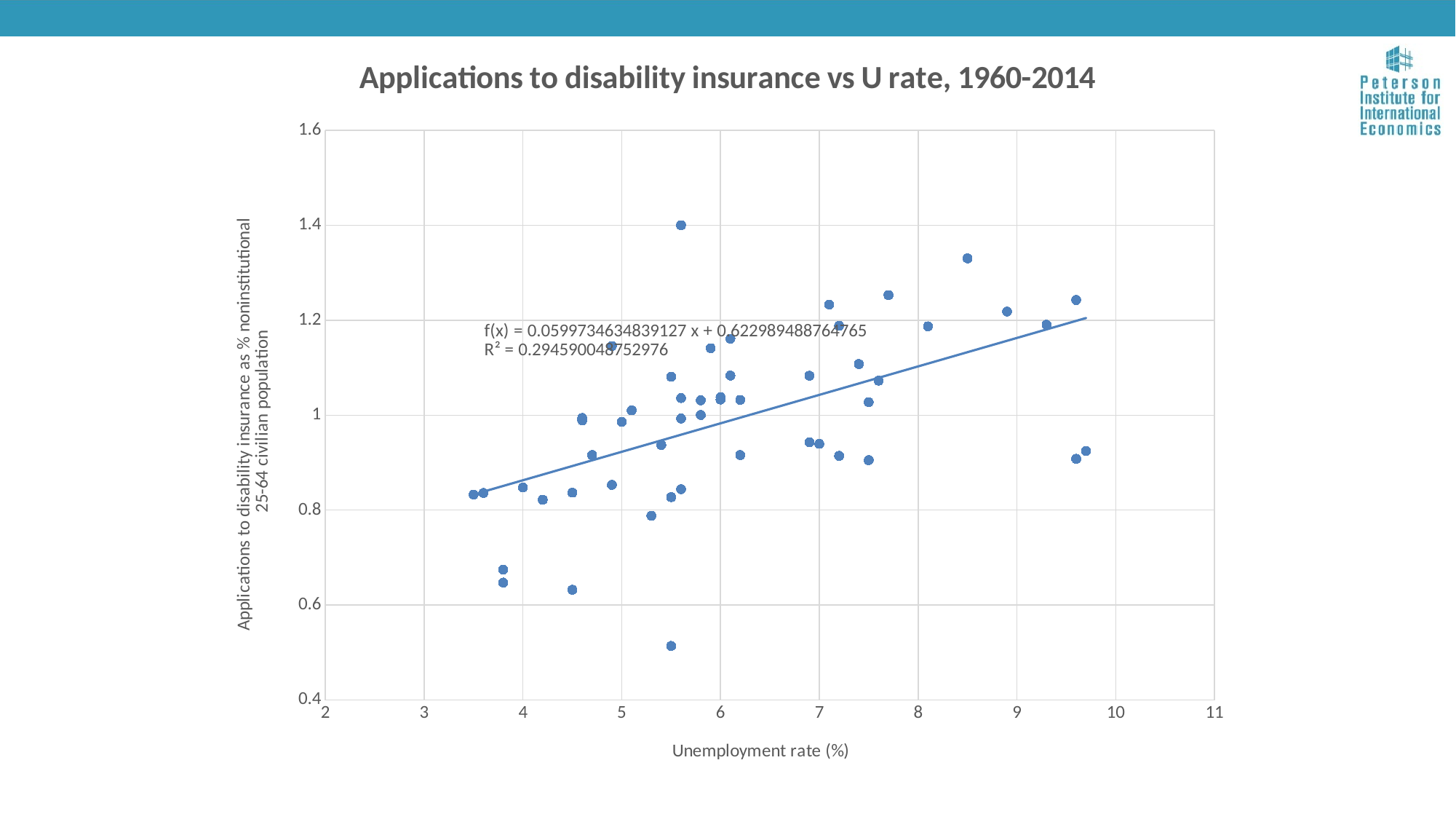
Is the value of the highest point on the chart (near an unemployment rate of 5.6) greater or less than 1.2? greater Which point has the higher application rate: the one at an unemployment rate of 8.5 or the one at 7.7? The one at 8.5 Is the value of the point at an unemployment rate of 3.5 greater or less than 1.0? less What kind of chart is shown on the slide? Scatter chart What R² value is printed on the chart for the trendline? 0.294590048752976 Is the value of the point at an unemployment rate of 8.5 greater or less than 1.2? greater According to the fitted trendline, do applications to disability insurance rise or fall as the unemployment rate increases? Rise What is the intercept of the fitted line f(x) printed on the chart? 0.622989488764765 What is the title of the chart? Applications to disability insurance vs U rate, 1960-2014 What is the slope of the fitted line f(x) printed on the chart? 0.0599734634839127 What is the label of the x axis? Unemployment rate (%)